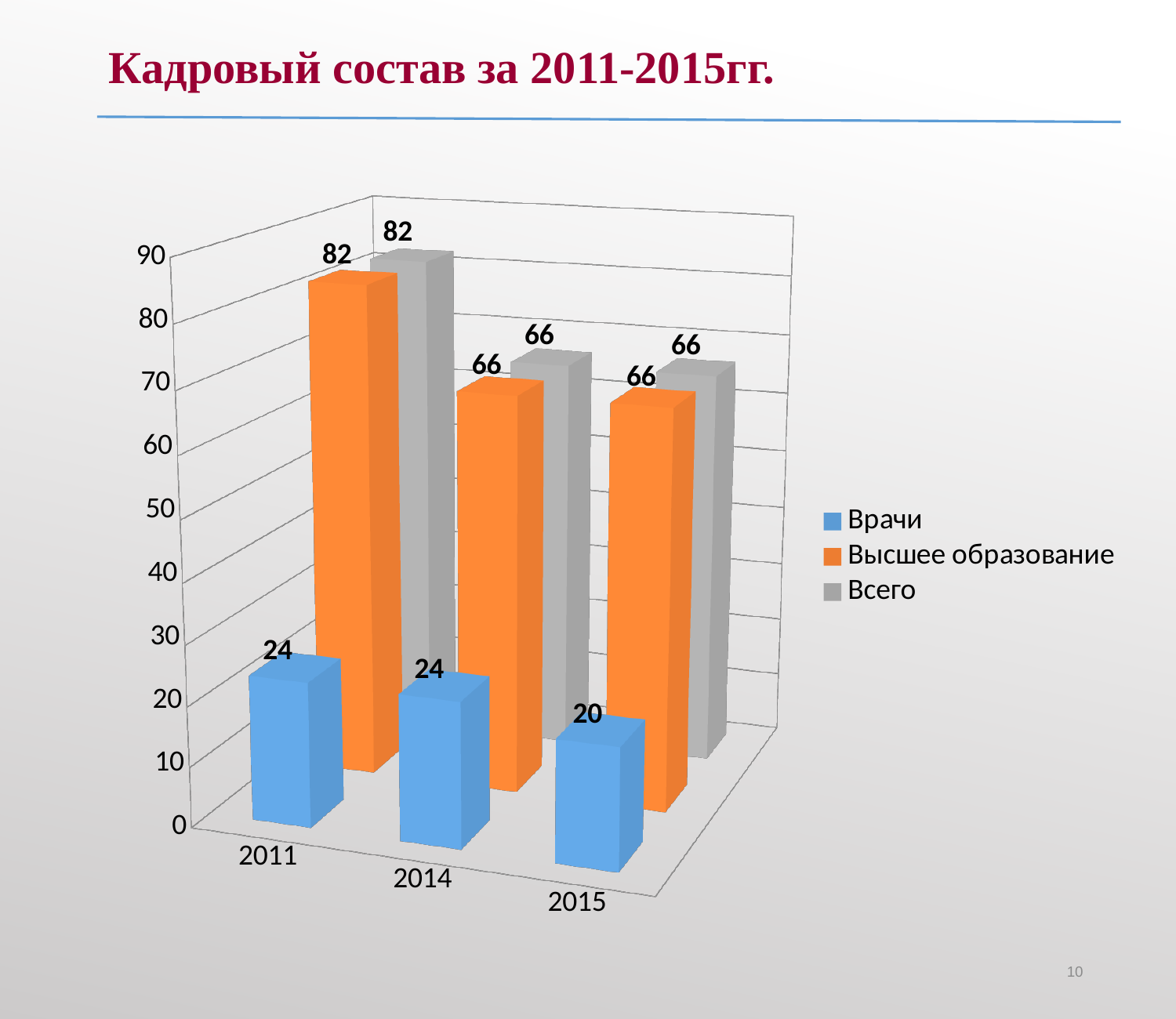
What is the difference between the Всего value in 2011 and in 2015? 16 How many years are shown on the x axis? 3 In which year is the value for Всего highest? 2011 Which is larger in 2014: the value for Врачи or the value for Высшее образование? Высшее образование How many series does the legend list? 3 In which year is the value for Врачи lowest? 2015 What is the value for Всего in 2014? 66 Does the value for Врачи rise or fall from 2011 to 2015? fall What is the value for Врачи in 2015? 20 What is the difference between the Врачи value in 2011 and in 2015? 4 What is the value for Высшее образование in 2011? 82 What kind of chart is shown on the slide? bar chart